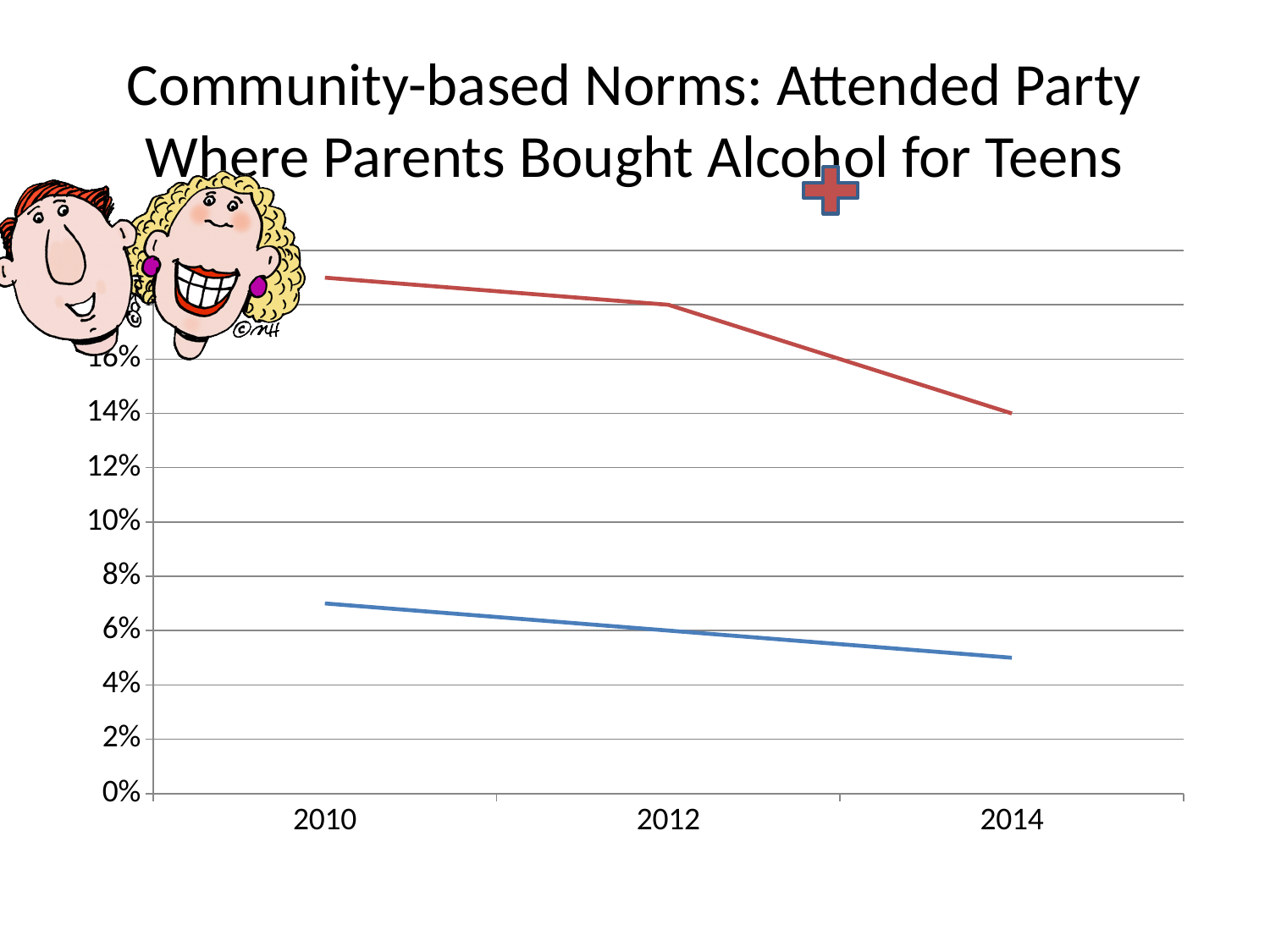
Is the value of the blue line in 2014 greater or less than 4%? greater In which year does the red line reach its highest value? 2010 Does the blue line rise or fall from 2010 to 2014? fall How many years are shown on the x axis of the chart? 3 Does the red line rise or fall from 2010 to 2014? fall What type of chart is shown on the slide? line chart How many lines are plotted on the chart? 2 What is the title of the chart? Community-based Norms: Attended Party Where Parents Bought Alcohol for Teens In 2010, which line has the higher value, the red line or the blue line? red line Is the value of the blue line in 2010 greater or less than 8%? less What is the value of the blue line in 2012? 6% What is the value of the red line in 2014? 14%